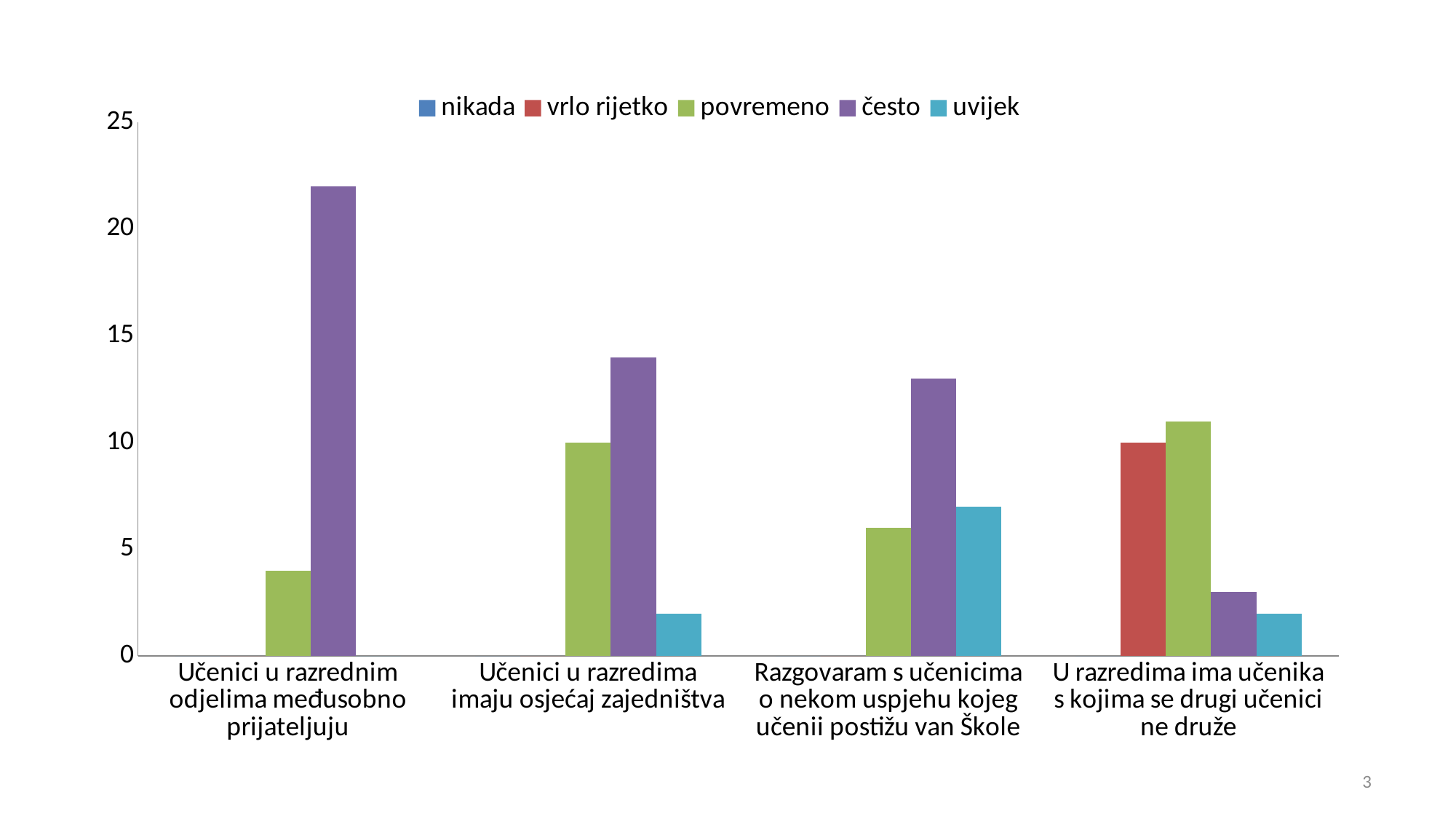
Is the value for 'često' in the category 'Učenici u razrednim odjelima međusobno prijateljuju' greater or less than 20? greater Which category has the lowest value for 'često'? U razredima ima učenika s kojima se drugi učenici ne druže In the category 'U razredima ima učenika s kojima se drugi učenici ne druže', which is larger: 'povremeno' or 'često'? povremeno Is the value for 'uvijek' in the category 'Razgovaram s učenicima o nekom uspjehu kojeg učenii postižu van Škole' greater or less than 5? greater How many categories are shown along the x axis? 4 Which series is shown in purple in the legend? često Is the value for 'povremeno' in the category 'Učenici u razrednim odjelima međusobno prijateljuju' greater or less than 5? less Which series has the tallest bar in the whole chart? često How many series does the legend list? 5 Do the values for 'često' rise or fall from left to right across the categories? fall What kind of chart is shown on the slide? bar chart